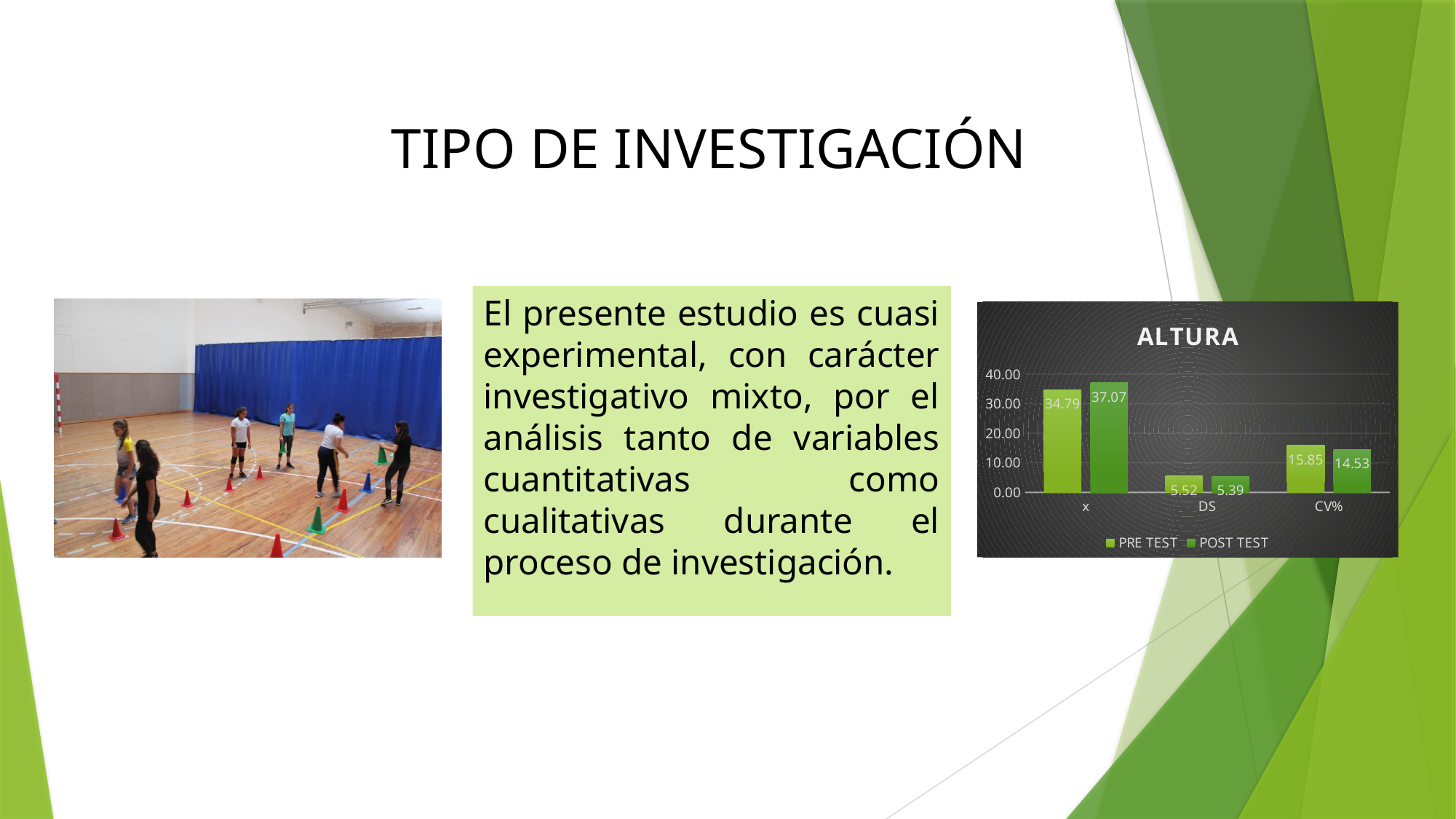
How many series does the legend of the ALTURA chart list? 2 What is the PRE TEST value for x in the ALTURA chart? 34.79 What is the POST TEST value for CV% in the ALTURA chart? 14.53 Which category has the lowest POST TEST value in the ALTURA chart? DS What is the difference between the POST TEST and PRE TEST values for x in the ALTURA chart? 2.28 What type of chart is the ALTURA chart? Bar chart Which category has the highest PRE TEST value in the ALTURA chart? x What is the POST TEST value for x in the ALTURA chart? 37.07 How many categories are shown on the x axis of the ALTURA chart? 3 For CV%, which is larger in the ALTURA chart: PRE TEST or POST TEST? PRE TEST What is the PRE TEST value for DS in the ALTURA chart? 5.52 What is the title of the chart on the slide? ALTURA